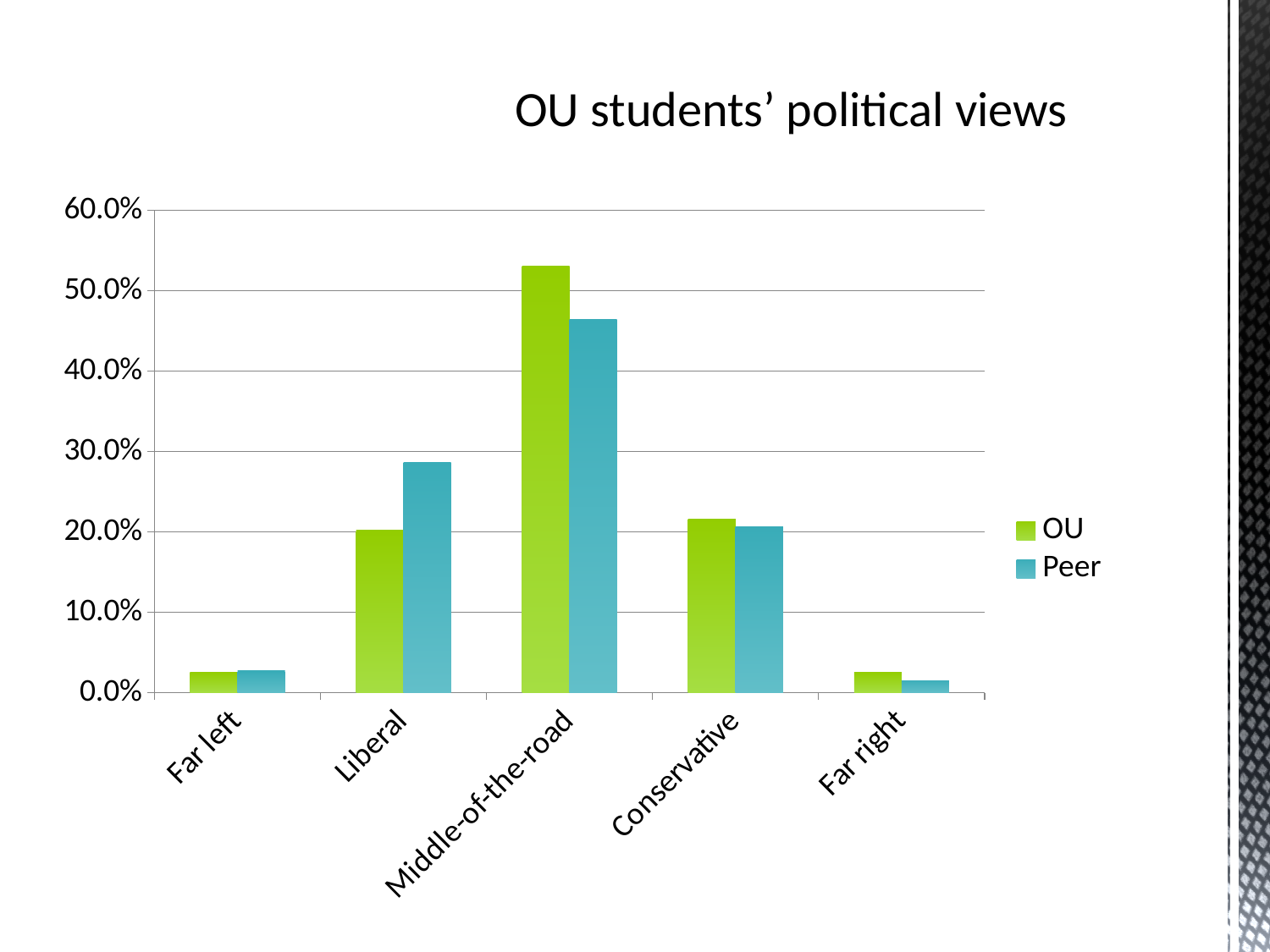
What type of chart is shown on the slide? Bar chart How many political view categories are shown on the x axis? 5 For the Liberal category, which series has the larger value, OU or Peer? Peer Which category has the highest value for the Peer series? Middle-of-the-road Is the OU value for Middle-of-the-road greater or less than 50.0%? greater Which category has the highest value for the OU series? Middle-of-the-road What is the title of the chart? OU students' political views Which category has the lowest value for the Peer series? Far right How many series does the legend list? 2 Is the Peer value for Liberal greater or less than 30.0%? less Is the Peer value for Far right greater or less than 10.0%? less For the Middle-of-the-road category, which series has the larger value, OU or Peer? OU